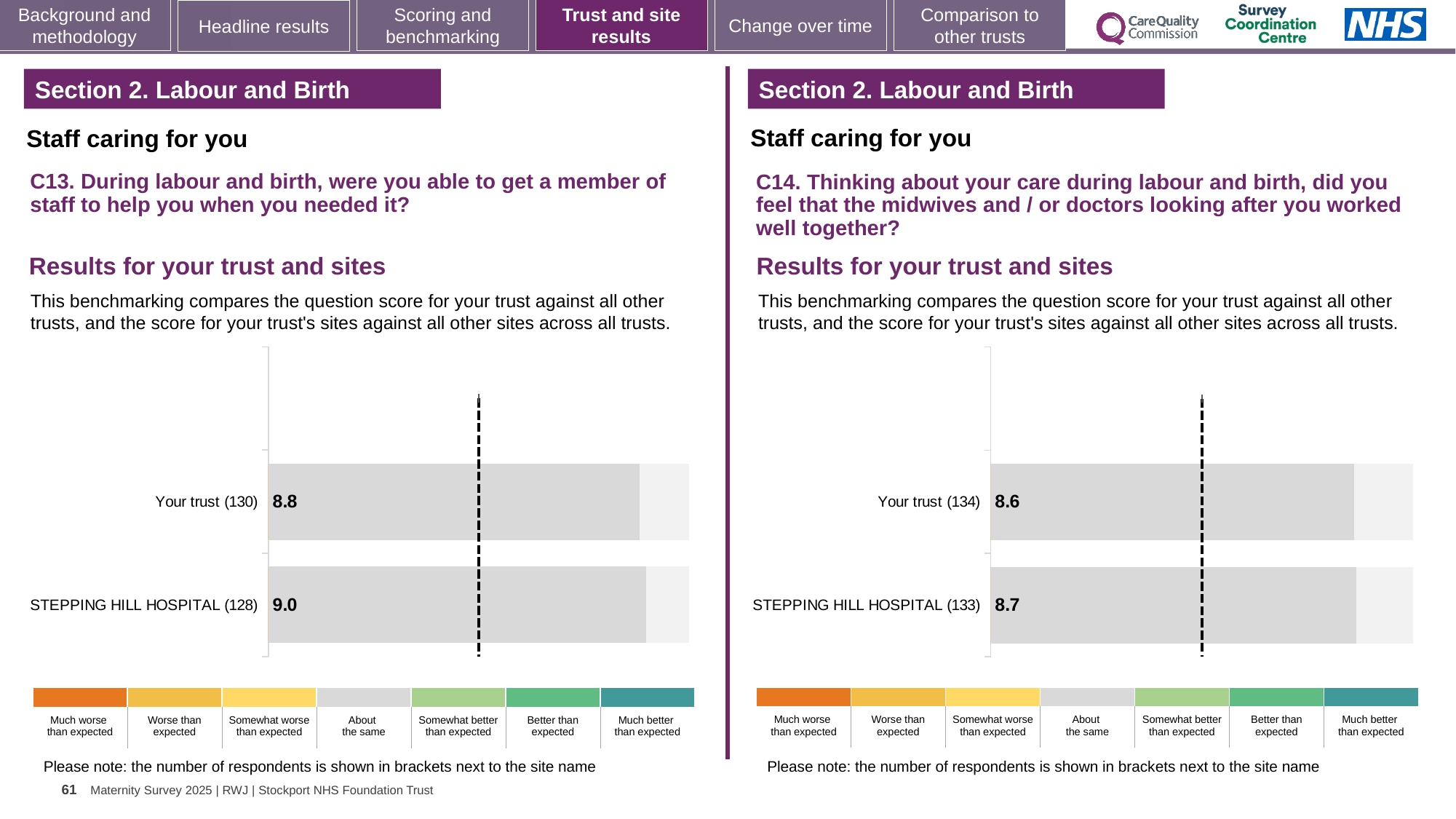
In the C14 chart on the right, what is the difference between the STEPPING HILL HOSPITAL score and the Your trust score? 0.1 In the C14 chart on the right, what is the score for Your trust? 8.6 In the C14 chart on the right, what is the score for STEPPING HILL HOSPITAL? 8.7 In the C13 chart on the left, what is the difference between the STEPPING HILL HOSPITAL score and the Your trust score? 0.2 In the C13 chart on the left, which has the higher score, Your trust or STEPPING HILL HOSPITAL? STEPPING HILL HOSPITAL How many bars are plotted in the C13 chart on the left? 2 In the C14 chart on the right, which has the lower score, Your trust or STEPPING HILL HOSPITAL? Your trust In the C14 chart on the right, how many respondents are shown in brackets for STEPPING HILL HOSPITAL? 133 In the C13 chart on the left, what is the score for STEPPING HILL HOSPITAL? 9.0 In the C13 chart on the left, how many respondents are shown in brackets for Your trust? 130 In the C13 chart on the left, what is the score for Your trust? 8.8 What kind of chart is used for the C14 results on the right? Bar chart